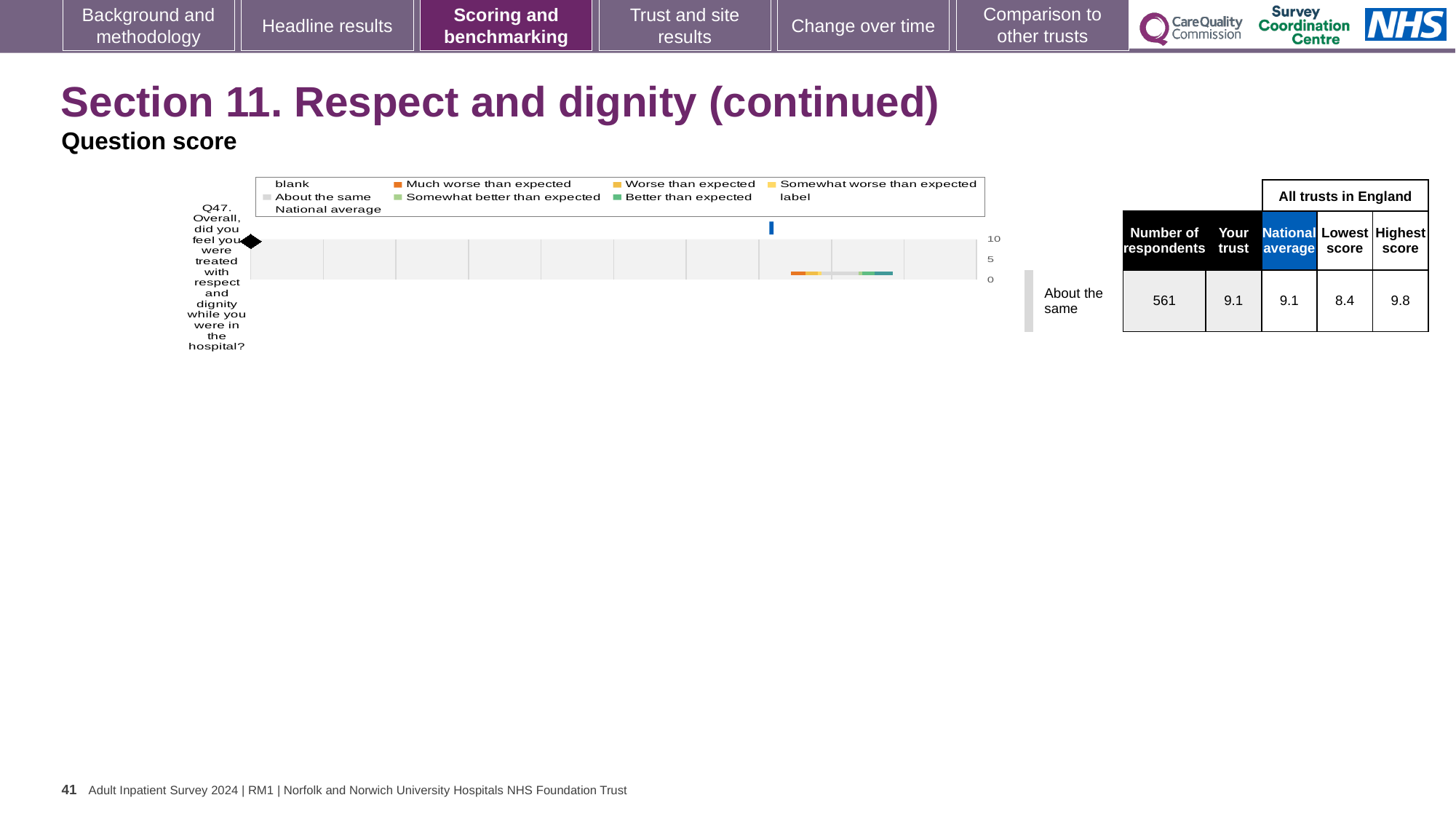
Which benchmarking category is Q47 placed in? About the same How many respondents answered Q47? 561 What is the national average score for Q47 in the table beside the chart? 9.1 Which question is shown on the chart? Q47. Overall, did you feel you were treated with respect and dignity while you were in the hospital? How many entries does the chart legend list? 9 What is the lowest score among all trusts in England for Q47? 8.4 What is the highest score among all trusts in England for Q47? 9.8 What is the maximum value shown on the chart's vertical axis? 10 What is the difference between the highest and lowest scores for Q47 across all trusts in England? 1.4 Is the trust's score for Q47 larger than, smaller than, or equal to the national average? equal What is the 'Your trust' score for Q47 in the table beside the chart? 9.1 How many questions are plotted on the chart? 1